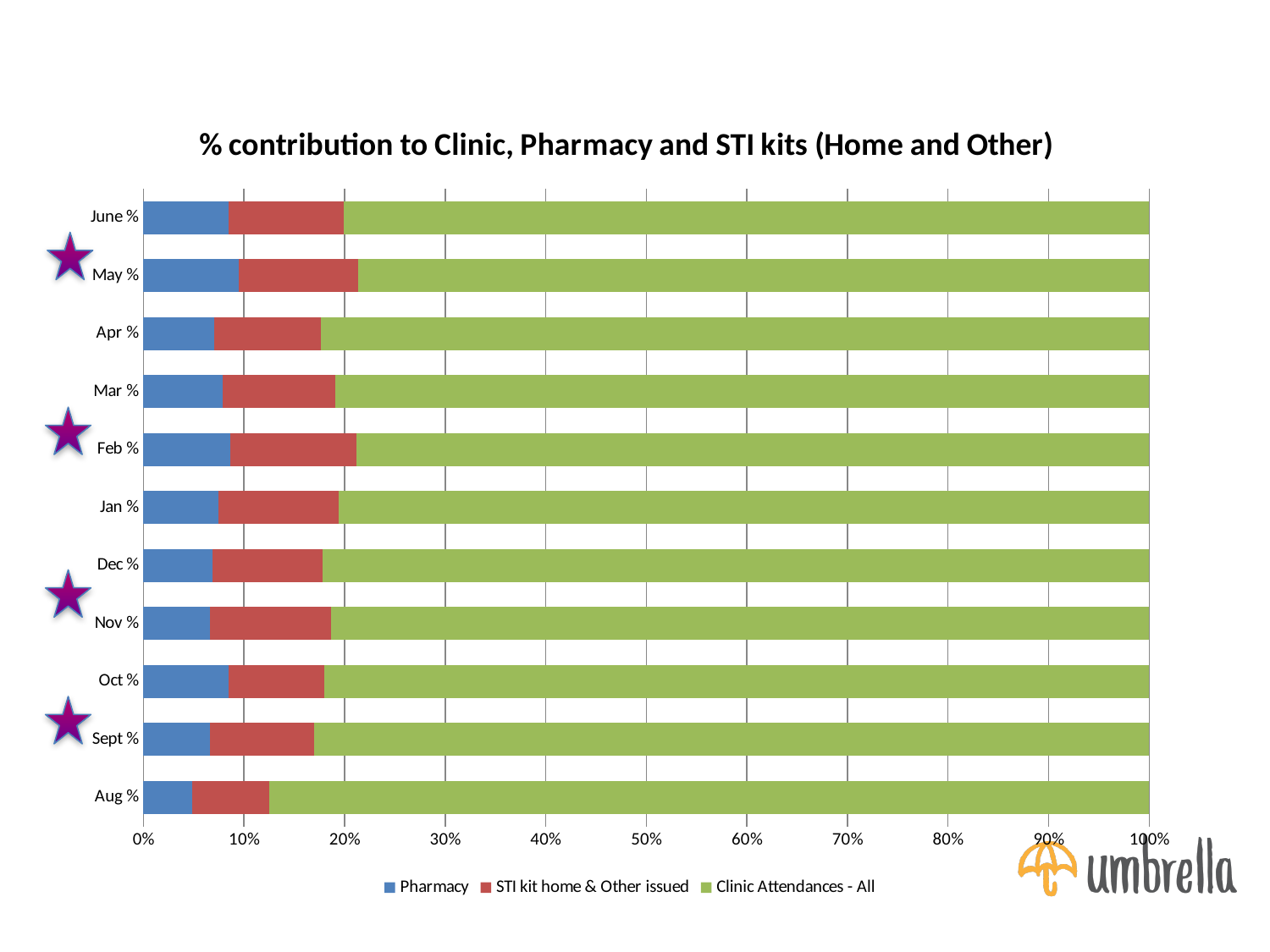
How many month categories are plotted on the chart? 11 Is the Clinic Attendances - All value for Aug % larger or smaller than the Clinic Attendances - All value for May %? larger Which series is shown in green? Clinic Attendances - All How many series does the legend list? 3 Is the Clinic Attendances - All value for Aug % greater or less than 80%? greater Which month has the smallest Pharmacy share? Aug % What is the total of the stacked bar for June %? 100% Which month has the largest Clinic Attendances - All share? Aug % What kind of chart is shown on the slide? bar chart What is the title of the chart? % contribution to Clinic, Pharmacy and STI kits (Home and Other) Is the Pharmacy value for Aug % greater or less than 10%? less Is the Pharmacy value for Aug % larger or smaller than the Pharmacy value for May %? smaller